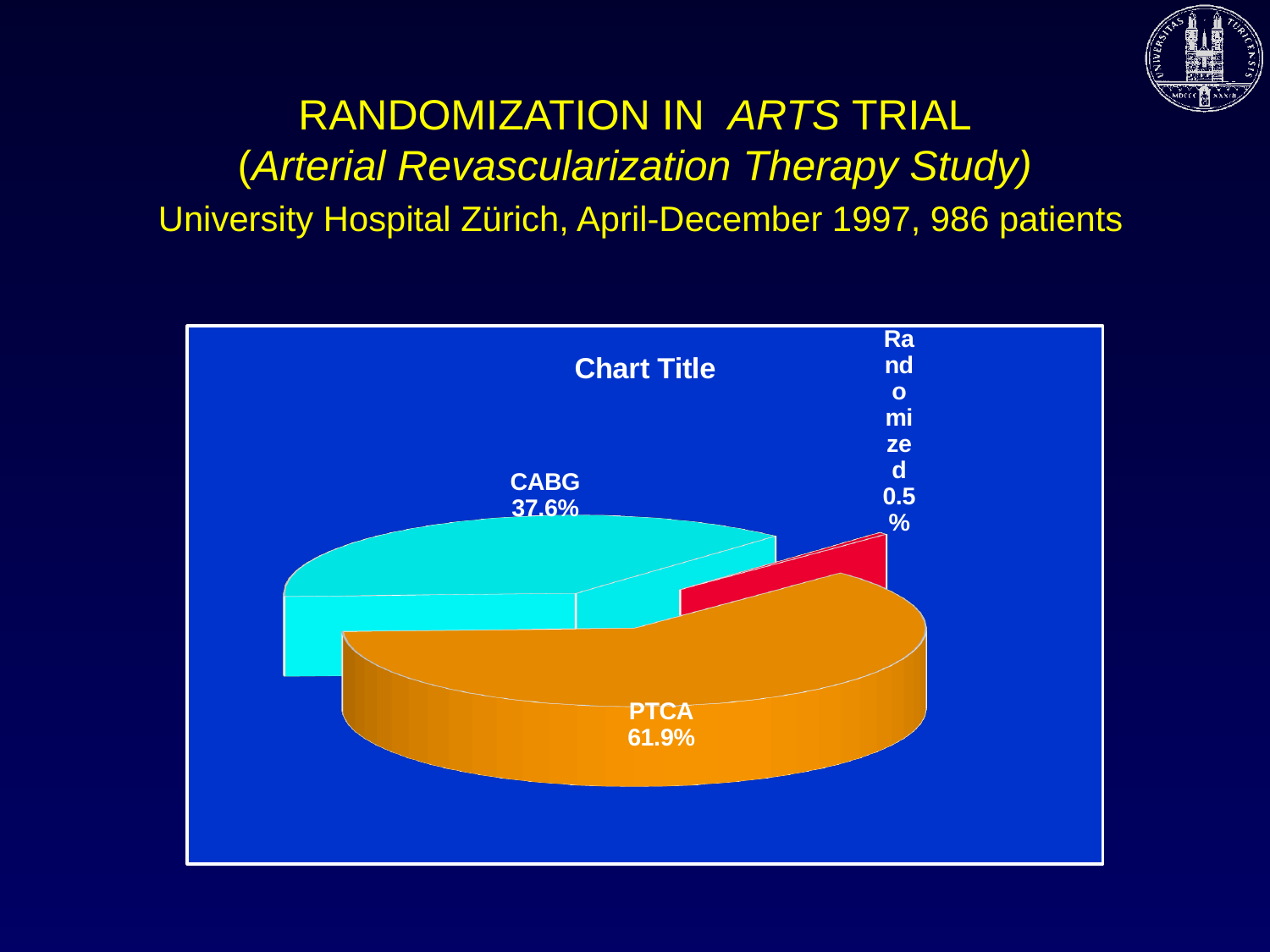
Which slice of the pie is the largest? PTCA What colour is the PTCA slice of the pie? orange What share of the pie is taken by the PTCA slice? 61.9% How many slices does the pie chart have? 3 What title is printed above the pie chart? Chart Title What percentage of the pie does the CABG slice represent? 37.6% What is the difference in percentage points between the PTCA slice and the CABG slice? 24.3% Which is larger, the CABG slice or the PTCA slice? PTCA What kind of chart is shown on the slide? pie chart What percentage of the pie does the PTCA slice represent? 61.9% What percentage is shown for the Randomized slice? 0.5% Which slice of the pie is the smallest? Randomized